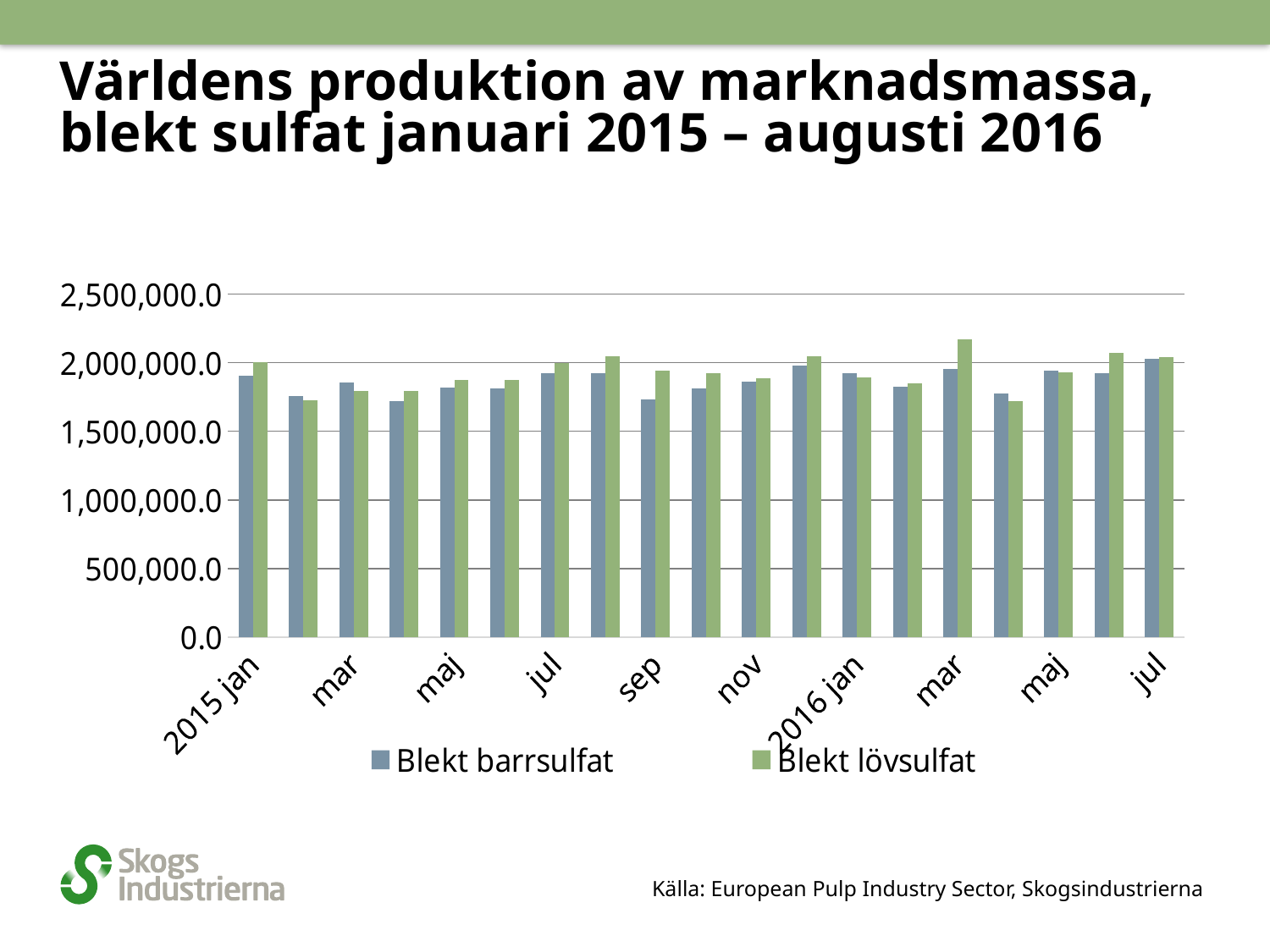
What are the two series named in the legend? Blekt barrsulfat and Blekt lövsulfat Is the value for Blekt barrsulfat in 2015 jan greater or less than 2,000,000.0? less Is the value for Blekt barrsulfat in 2015 sep greater or less than 2,000,000.0? less In 2015 jan, which series has the larger value, Blekt barrsulfat or Blekt lövsulfat? Blekt lövsulfat In 2016 mar, which series has the larger value, Blekt barrsulfat or Blekt lövsulfat? Blekt lövsulfat Is the value for Blekt lövsulfat in 2016 mar greater or less than 2,000,000.0? greater What is the title of the chart on the slide? Världens produktion av marknadsmassa, blekt sulfat januari 2015 – augusti 2016 In which month does Blekt lövsulfat reach its highest value? 2016 mar What kind of chart is shown on the slide? Bar chart How many series does the legend list? 2